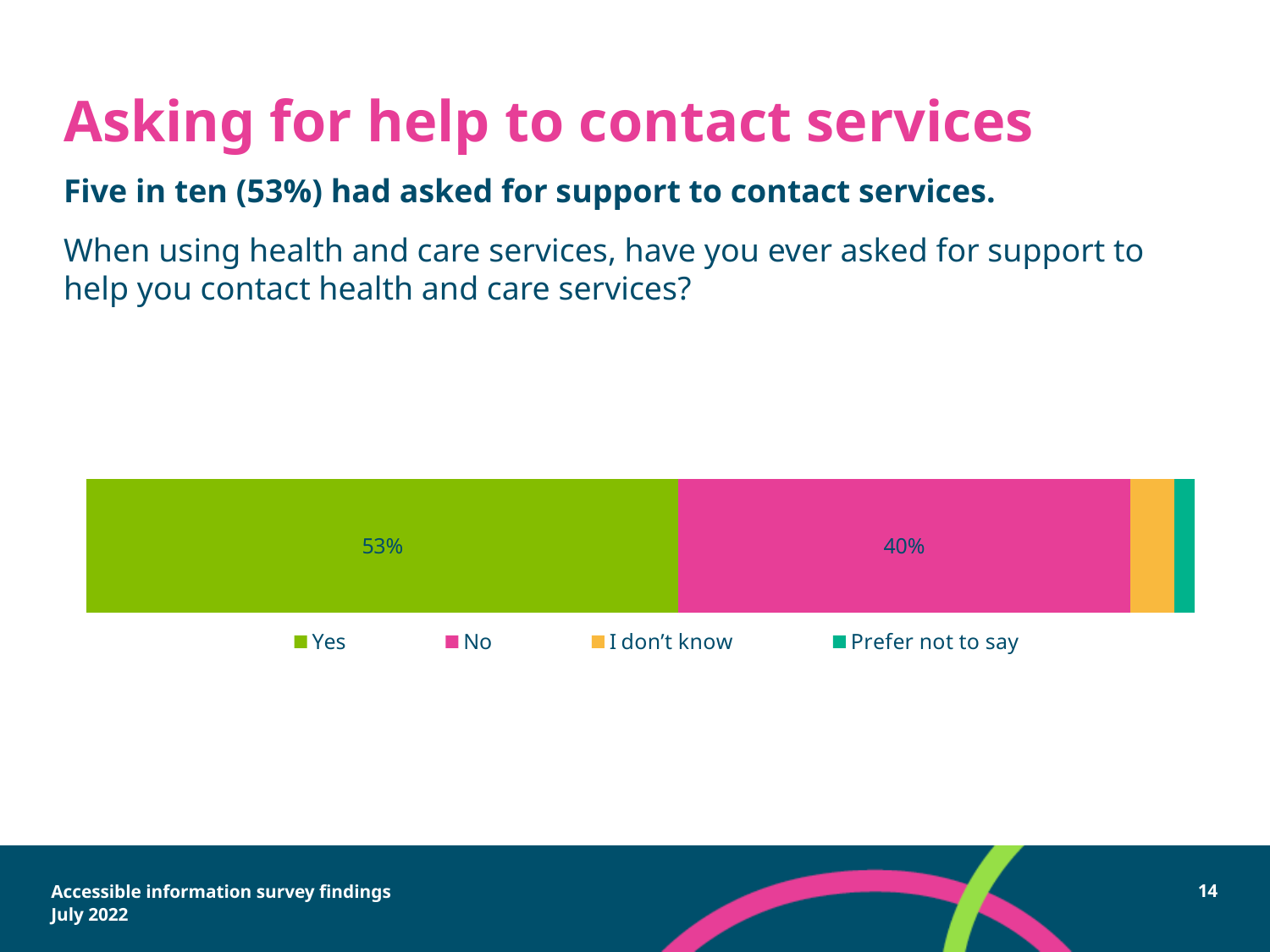
Which is larger, the share answering "Yes" or the share answering "No"? Yes Which of the two segments is smaller, "I don't know" or "No"? I don't know What percentage of respondents answered "No"? 40% What is the difference in percentage points between the "Yes" and "No" responses? 13 percentage points What percentage of respondents answered "Yes" to having asked for support to contact health and care services? 53% Which response category is shown in orange in the chart? I don't know What kind of chart is shown on the slide? Stacked bar chart Which response category has the largest share of the bar? Yes How many response categories does the legend list? 4 Which response category is shown in green in the chart? Yes